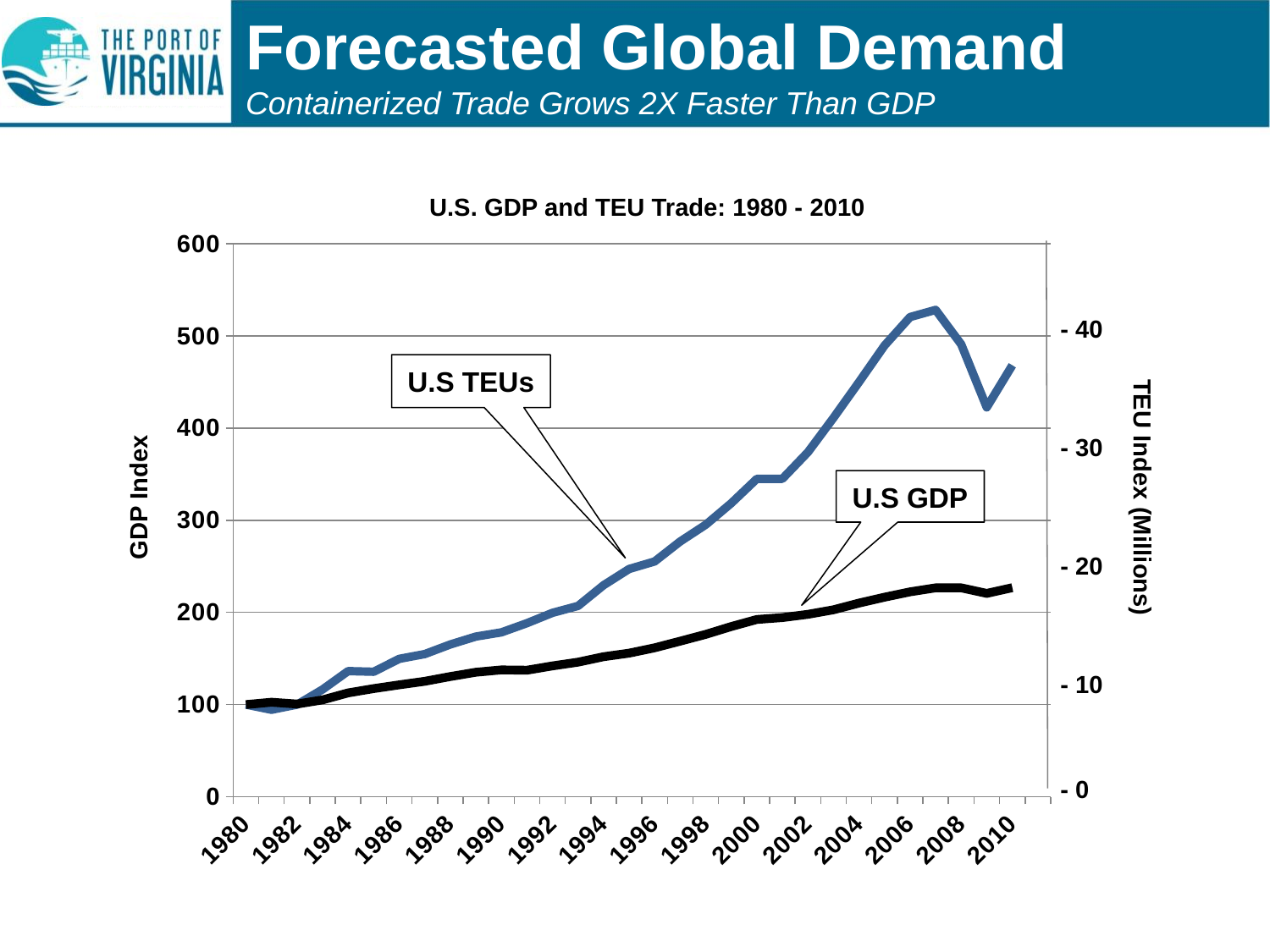
Is the U.S GDP value in 2010 greater or less than 200 on the GDP Index axis? greater What is the title of the chart? U.S. GDP and TEU Trade: 1980 - 2010 In which year does the U.S TEUs line reach its highest point? 2007 What is the label of the right-hand vertical axis? TEU Index (Millions) Is the U.S TEUs value in 1990 greater or less than 20 on the TEU Index axis? less Is the U.S GDP value in 1990 greater or less than 200 on the GDP Index axis? less Between 2007 and 2009, does the U.S TEUs line rise or fall? fall How many data series are plotted on the chart? 2 What kind of chart is shown on the slide? line chart Which line is plotted higher on the chart in 2010, U.S TEUs or U.S GDP? U.S TEUs Does the U.S GDP line generally rise or fall from 1980 to 2010? rise